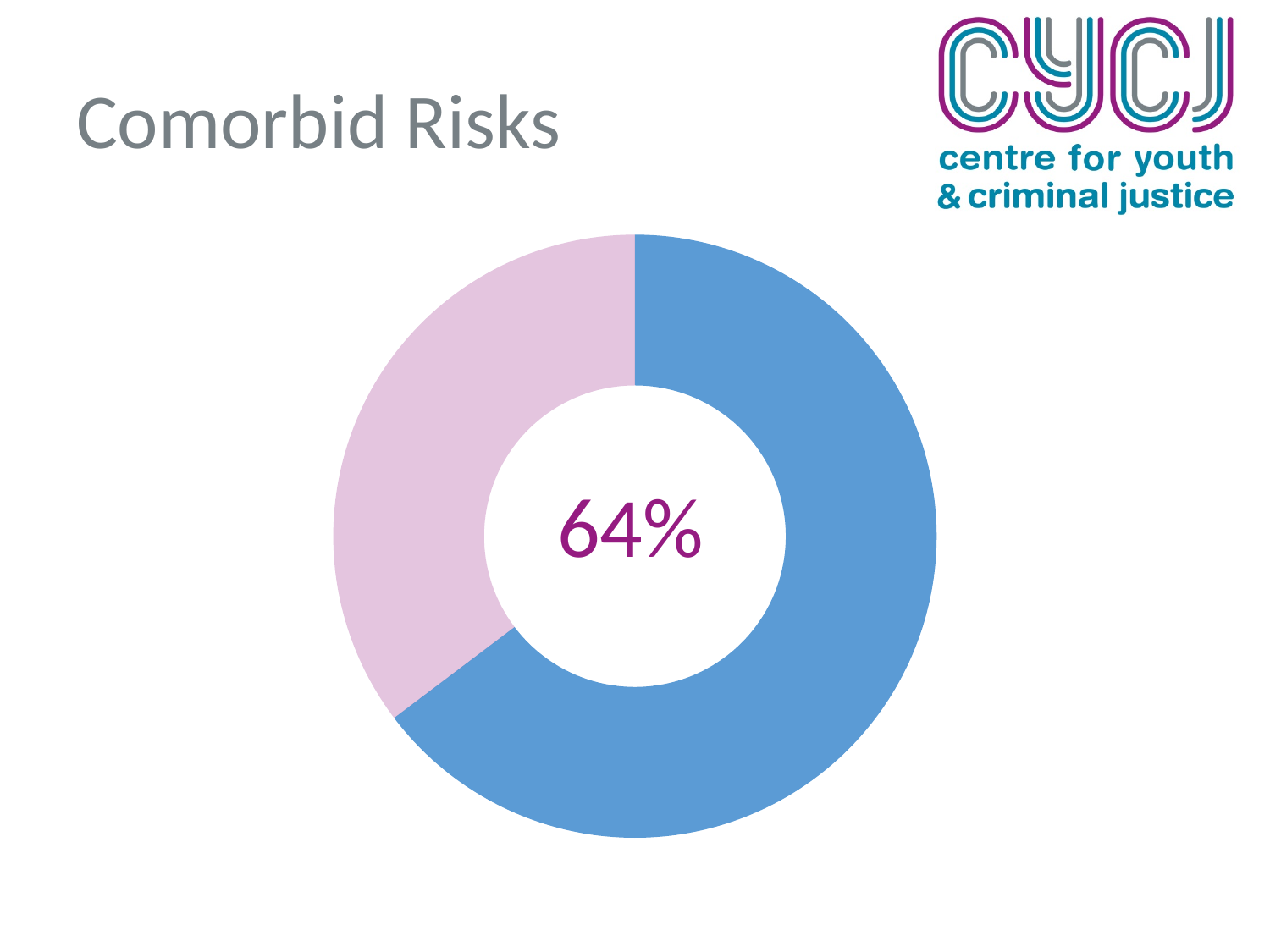
How many slices does the doughnut chart have? 2 What kind of chart is shown on the slide? doughnut chart What two colours are used for the slices of the doughnut chart? blue and pink What is the title of the slide containing the chart? Comorbid Risks Which slice of the doughnut chart is larger, the blue one or the pink one? blue Which colour slice is the smallest in the doughnut chart? pink What percentage value is printed in the centre of the doughnut chart? 64% Is the blue slice's share of the doughnut chart greater or less than 50%? greater Is the pink slice's share of the doughnut chart greater or less than 50%? less Which colour slice is the largest in the doughnut chart? blue